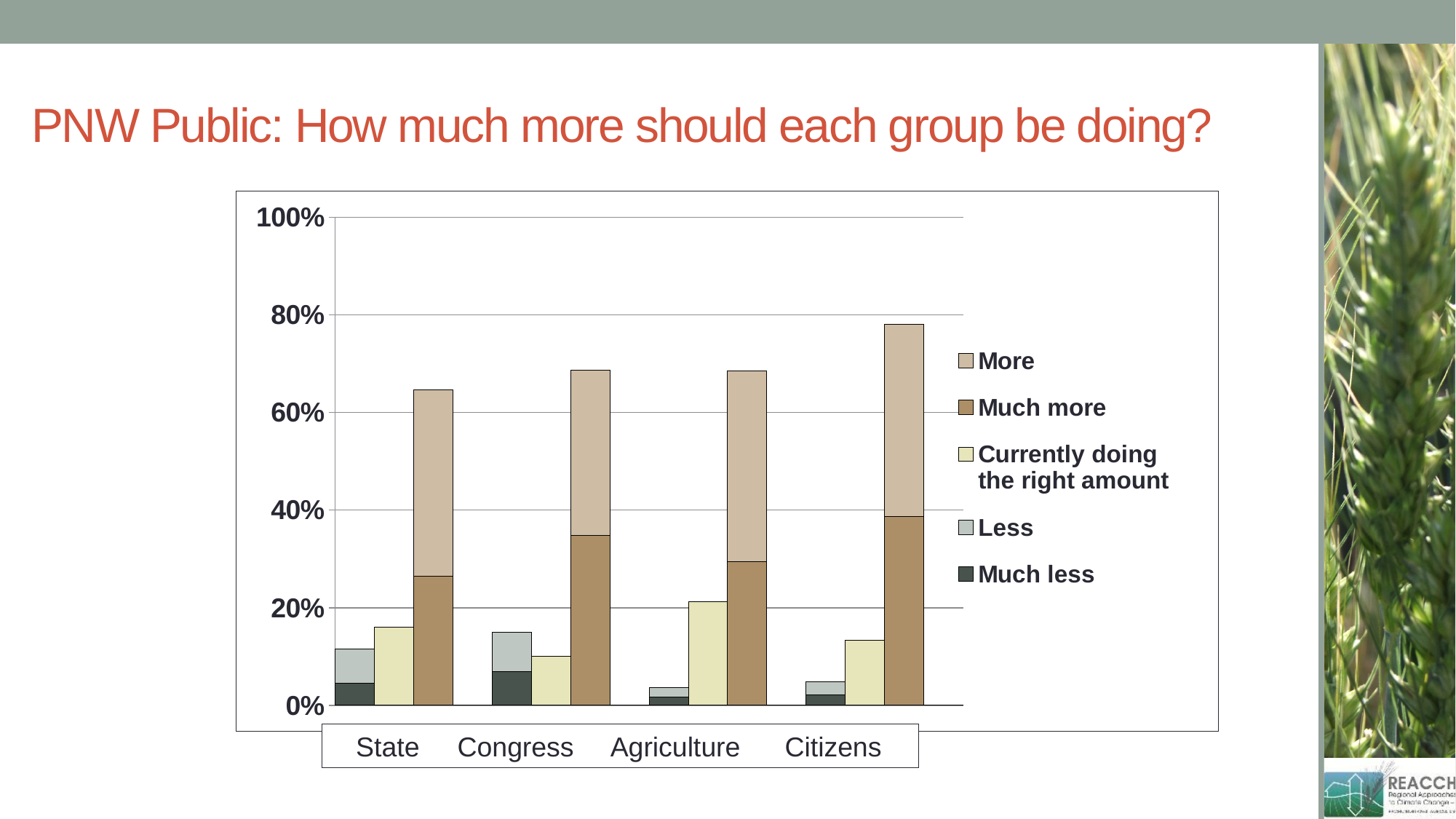
Which group has the shortest stacked bar for 'More' plus 'Much more'? State How many groups are shown on the x axis of the chart? 4 Is the value for 'Currently doing the right amount' for Congress greater or less than 20%? less Which group has the tallest stacked bar for 'More' plus 'Much more'? Citizens Is the stacked 'More' plus 'Much more' bar for Citizens greater or less than 60%? greater How many series does the chart's legend list? 5 What is the title of the slide containing the chart? PNW Public: How much more should each group be doing? Which is larger, the 'Much more' segment for Citizens or for State? Citizens Which group has the tallest stacked bar for 'Less' plus 'Much less'? Congress Which group has the highest value for 'Currently doing the right amount'? Agriculture What kind of chart is shown on the slide? bar chart Which group has the lowest value for 'Currently doing the right amount'? Congress